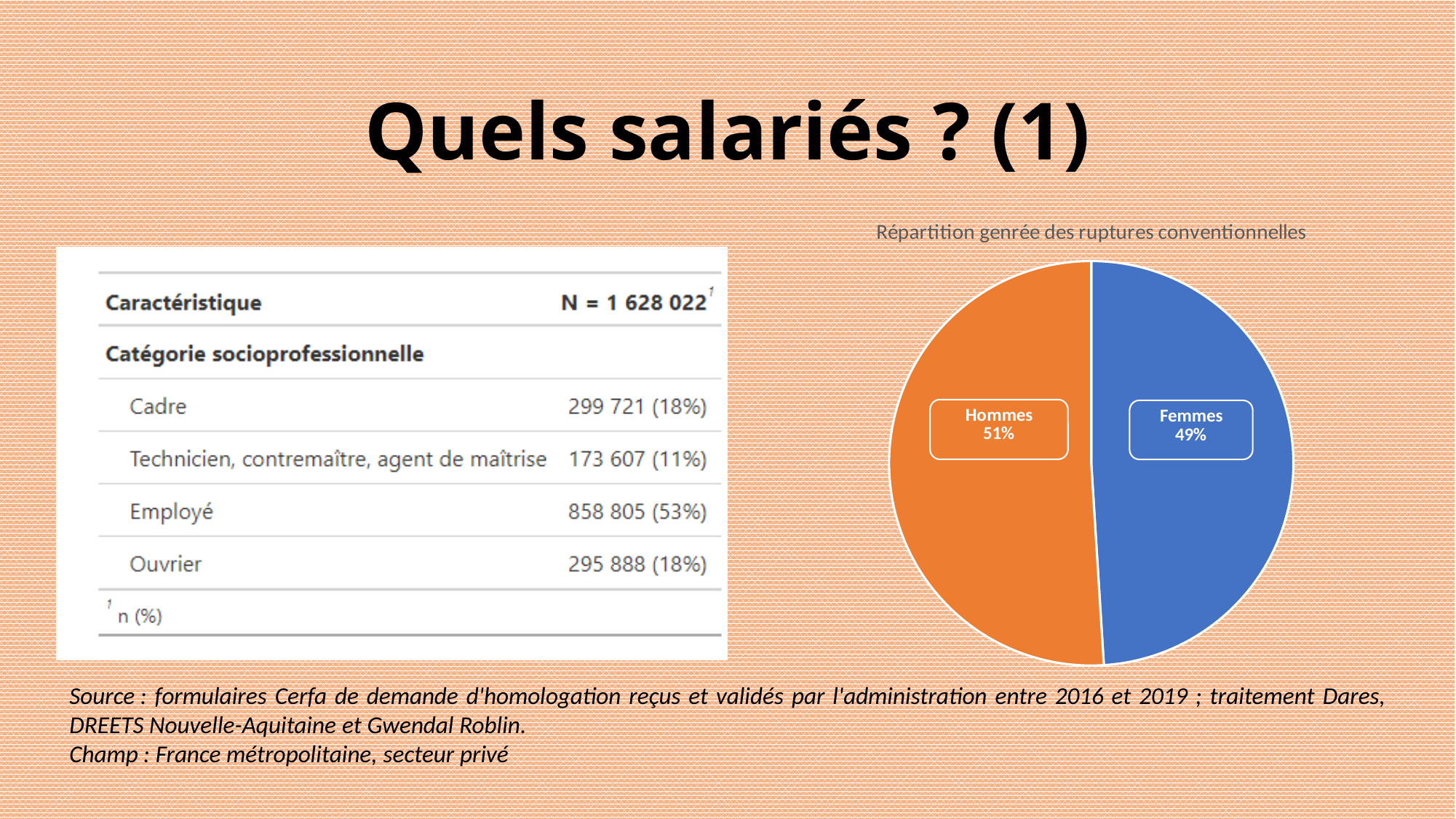
Which is larger in the pie chart, Hommes or Femmes? Hommes How many slices does the pie chart have? 2 What kind of chart is shown on the slide? pie chart What share of the pie chart is Hommes? 51% Which slice of the pie chart is the smallest? Femmes Which slice of the pie chart is the largest? Hommes Is the share for Hommes in the pie chart greater or less than 50%? greater What is the difference in percentage points between the Hommes and Femmes slices? 2 percentage points What is the title of the pie chart? Répartition genrée des ruptures conventionnelles What colour is the Femmes slice in the pie chart? blue What share of the pie chart is Femmes? 49%